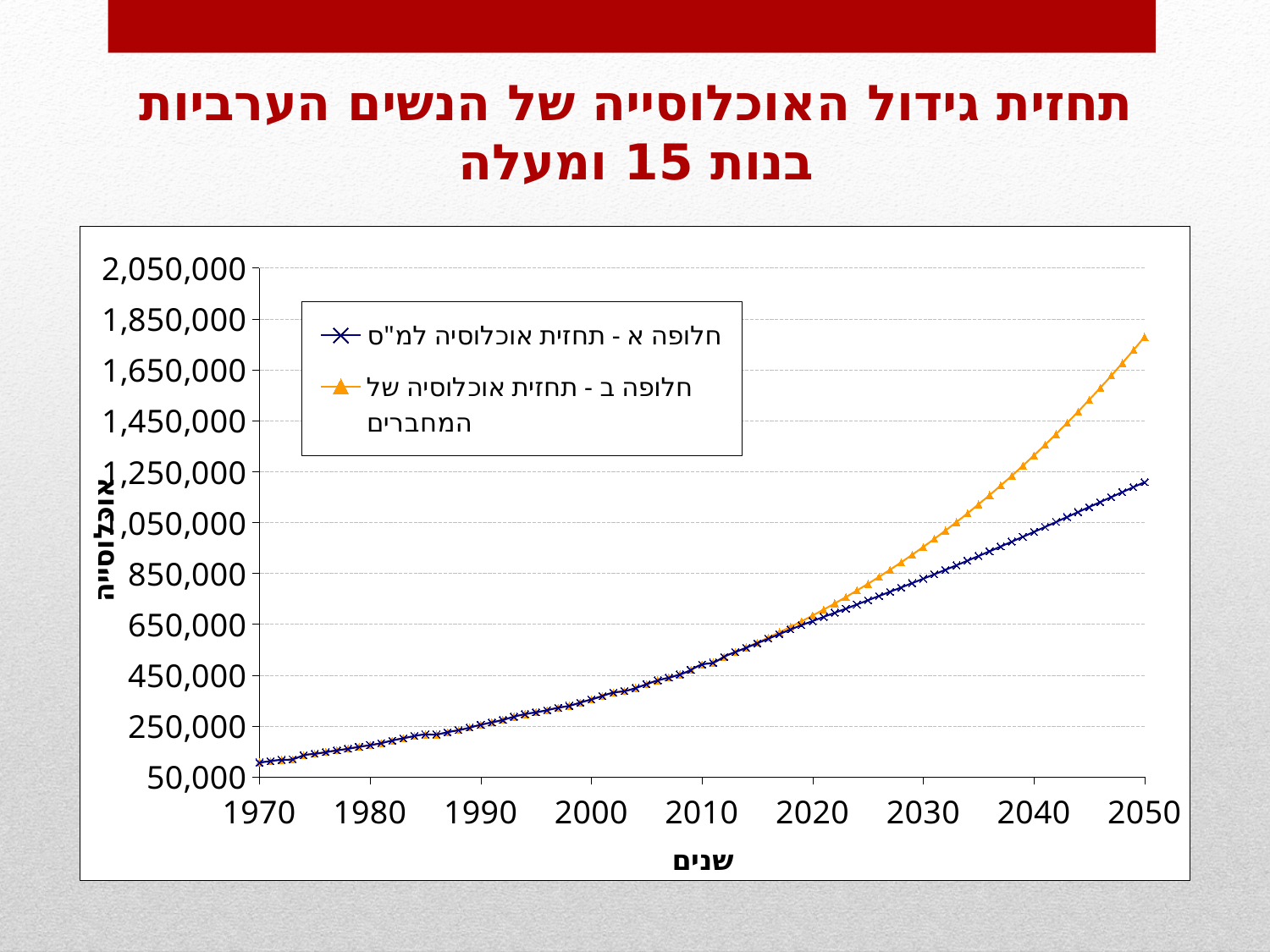
Is the value for חלופה א - תחזית אוכלוסיה למ"ס in 2050 greater or less than 1,050,000? greater What is the title of the x axis? שנים In 2050, which series has the higher value: חלופה א - תחזית אוכלוסיה למ"ס or חלופה ב - תחזית אוכלוסיה של המחברים? חלופה ב - תחזית אוכלוסיה של המחברים Is the value for חלופה א - תחזית אוכלוסיה למ"ס in 2030 greater or less than 1,050,000? less What kind of chart is shown on the slide? line chart How many series does the legend list? 2 Do the values of חלופה א - תחזית אוכלוסיה למ"ס rise or fall from 1970 to 2050? rise Do the values of חלופה ב - תחזית אוכלוסיה של המחברים rise or fall from 1970 to 2050? rise Is the value for חלופה א - תחזית אוכלוסיה למ"ס in 1970 greater or less than 250,000? less How many year labels are shown on the x axis? 9 Which series is drawn with orange triangle markers? חלופה ב - תחזית אוכלוסיה של המחברים